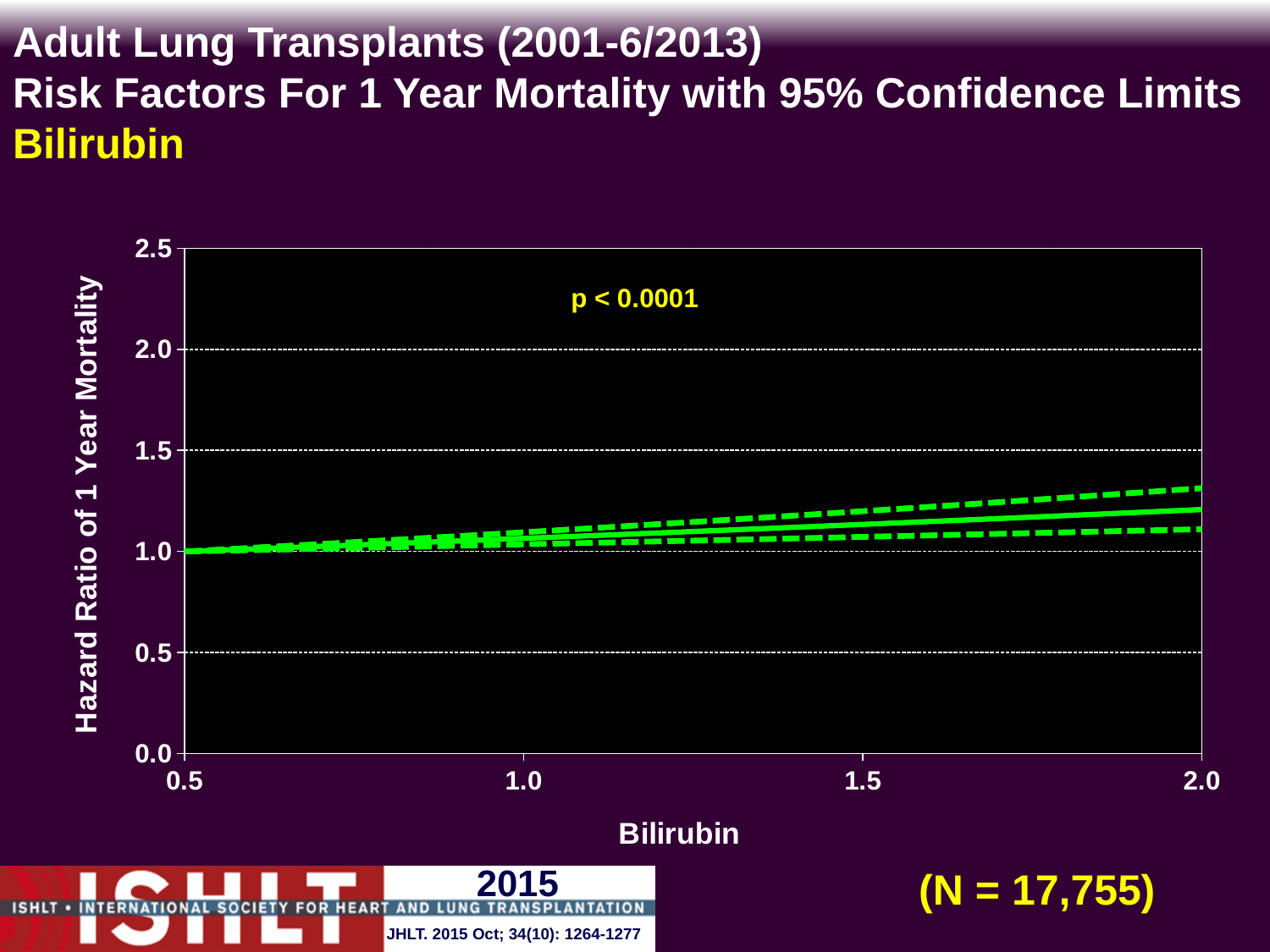
Is the hazard ratio at a bilirubin of 2.0 greater or less than 1.5? less What is the highest value shown on the y axis of the chart? 2.5 Does the hazard ratio of 1 year mortality rise or fall as bilirubin increases from 0.5 to 2.0? rise Is the hazard ratio at a bilirubin of 1.0 greater or less than 1.5? less Is the hazard ratio at a bilirubin of 2.0 greater or less than 1.0? greater How many lines are plotted on the chart (the hazard ratio and its confidence limits)? 3 What p-value is printed on the chart? p < 0.0001 What kind of chart is shown on the slide? line chart